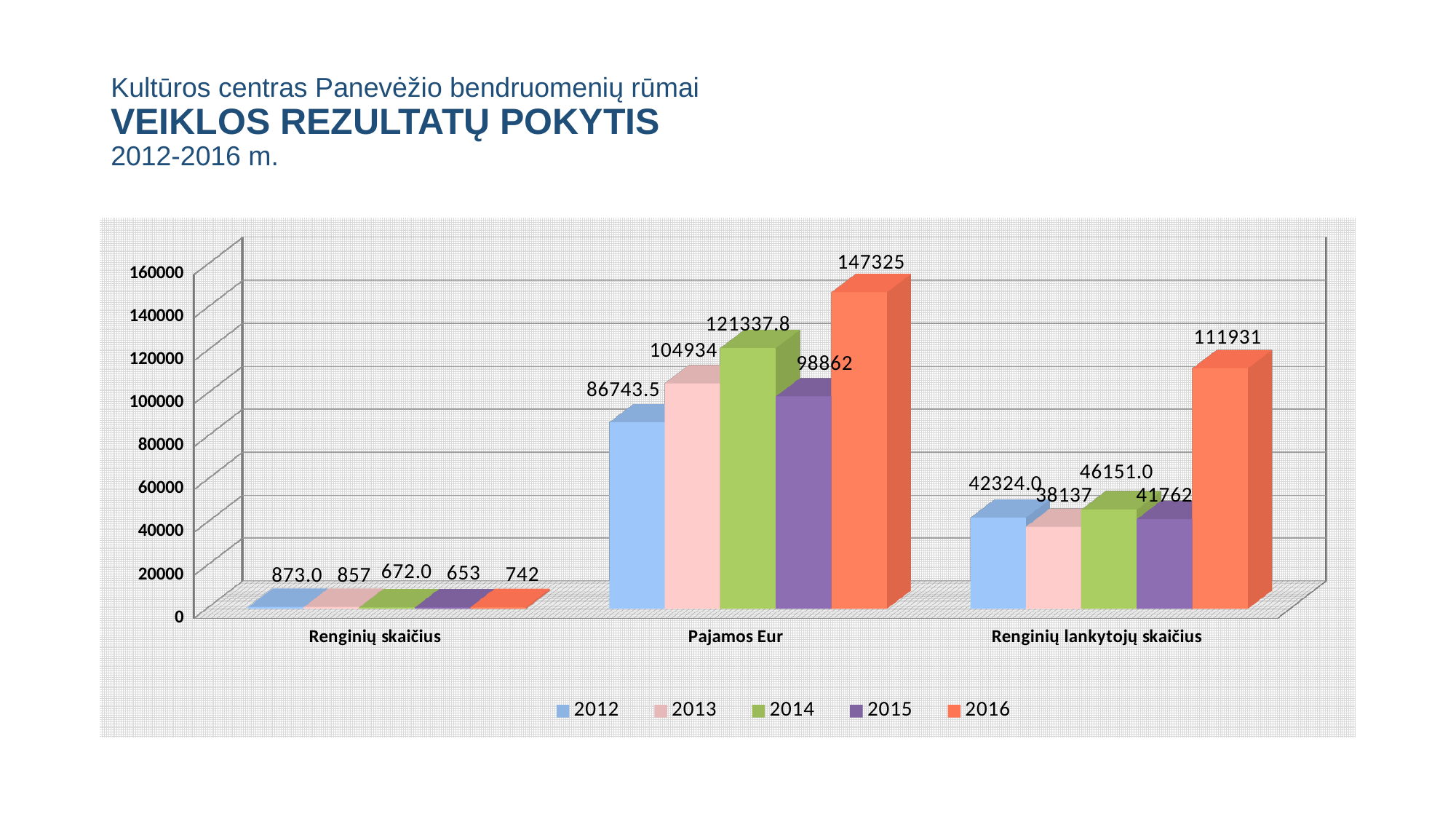
Which year has the lowest value in the Renginių skaičius category? 2015 What is the difference between the 2016 and 2015 values in the Pajamos Eur category? 48463 Is the value for 2013 in the Pajamos Eur category greater or less than 100000? greater How many categories are shown on the x axis? 3 What is the value for 2013 in the Renginių lankytojų skaičius category? 38137 Which year has the highest value in the Renginių lankytojų skaičius category? 2016 What is the value for 2012 in the Renginių skaičius category? 873.0 What is the value for 2016 in the Pajamos Eur category? 147325 What is the value for 2014 in the Pajamos Eur category? 121337.8 In the Renginių lankytojų skaičius category, which is larger: the value for 2014 or the value for 2015? 2014 What kind of chart is shown on the slide? bar chart How many series does the legend list? 5